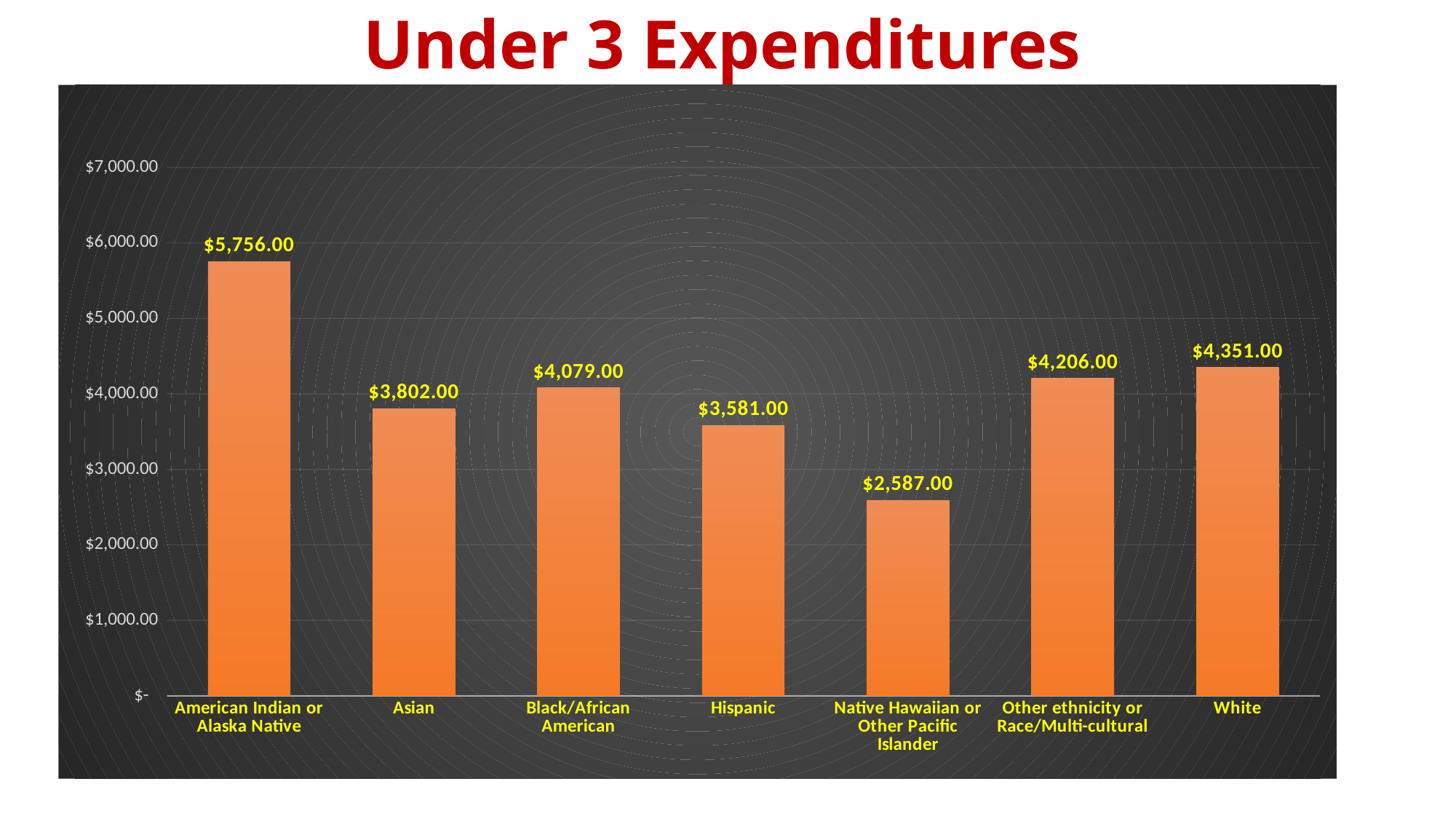
What is the value for Asian? $3,802.00 Which category has the lowest value? Native Hawaiian or Other Pacific Islander What is the value for Native Hawaiian or Other Pacific Islander? $2,587.00 How many categories are shown on the chart? 7 Which is larger, the value for Other ethnicity or Race/Multi-cultural or the value for Black/African American? Other ethnicity or Race/Multi-cultural Which category has the highest value? American Indian or Alaska Native Is the value for Hispanic greater or less than $4,000.00? less What is the title of the chart? Under 3 Expenditures What is the difference between the values for Black/African American and Hispanic? $498.00 What is the difference between the values for American Indian or Alaska Native and White? $1,405.00 What kind of chart is shown on the slide? bar chart What is the value for White? $4,351.00